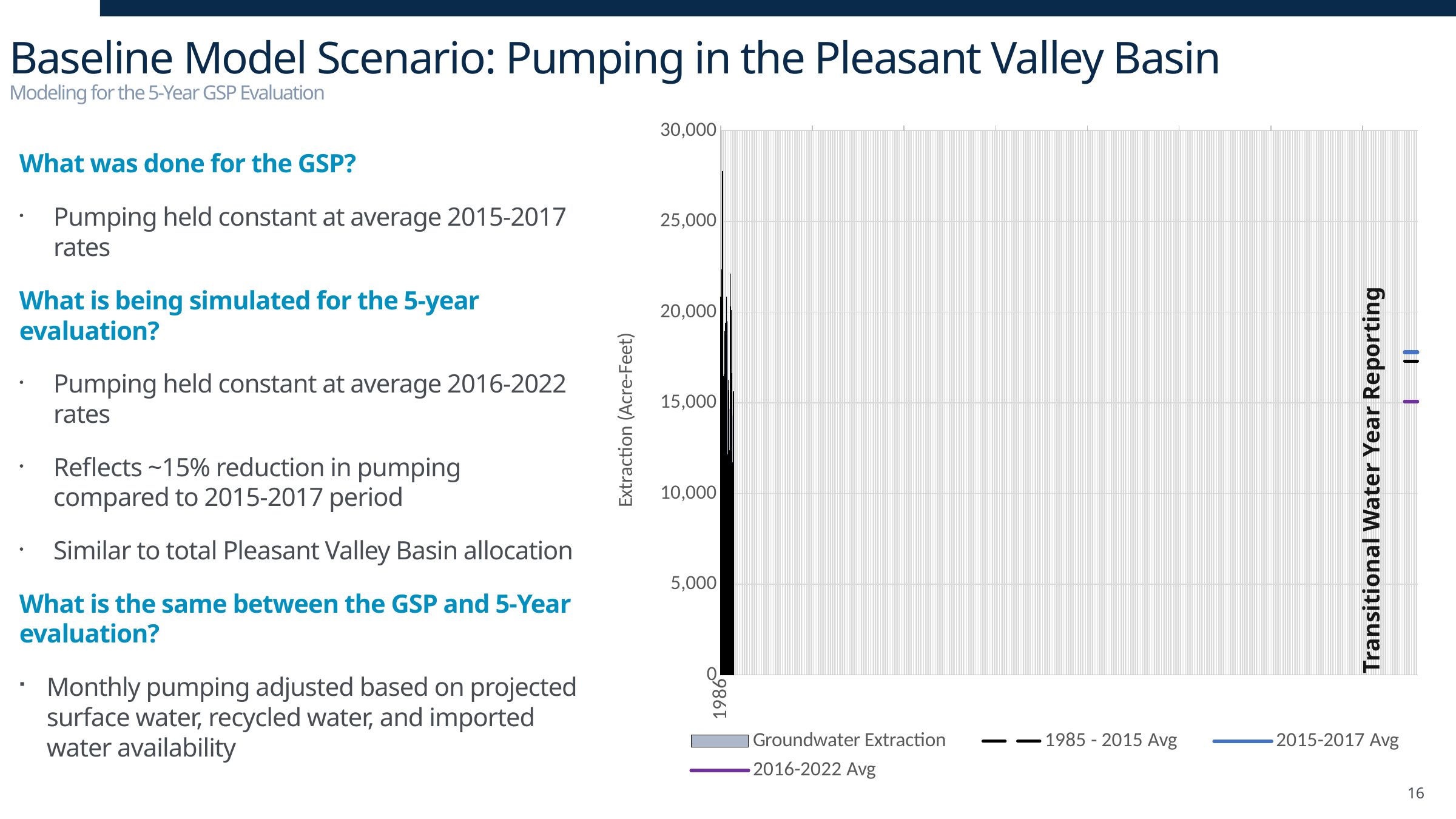
Is the 2015-2017 Avg line on the chart greater or less than 15,000 acre-feet? greater Is the 2015-2017 Avg line on the chart greater or less than 20,000 acre-feet? less Which is higher on the chart, the 2015-2017 Avg line or the 2016-2022 Avg line? 2015-2017 Avg How many series does the chart legend list? 4 Is the 2016-2022 Avg line on the chart greater or less than 20,000 acre-feet? less What kind of chart is used to show Groundwater Extraction? bar chart What is the highest value shown on the chart's vertical axis? 30,000 What is the label on the vertical axis of the chart? Extraction (Acre-Feet)